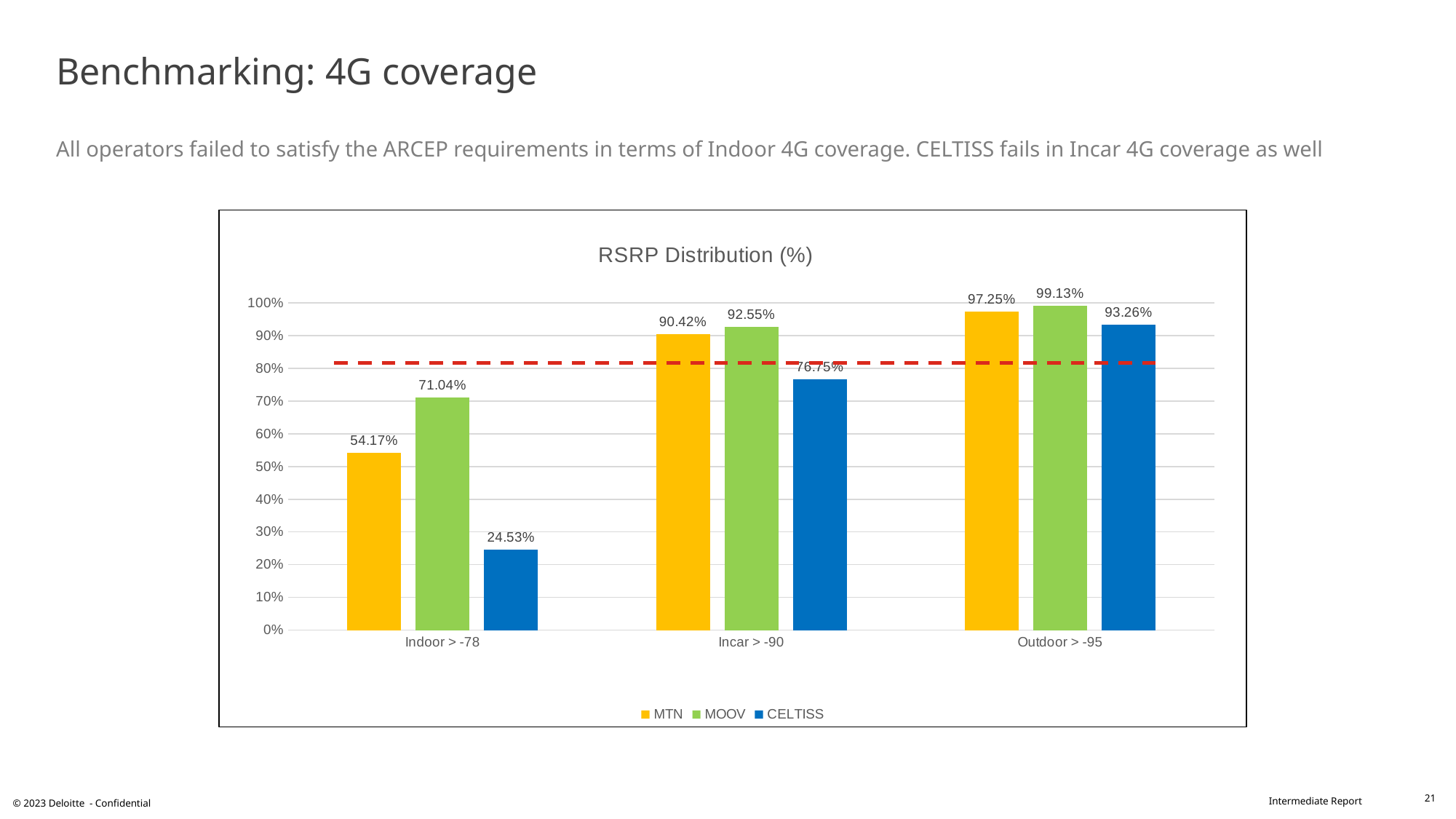
What is the title of the chart? RSRP Distribution (%) How many categories are shown on the x axis? 3 What is the value for CELTISS in the Incar > -90 category? 76.75% Which operator has the highest value in the Outdoor > -95 category? MOOV What kind of chart is shown on the slide? Bar chart What is the value for MTN in the Indoor > -78 category? 54.17% What is the difference between MOOV and MTN in the Indoor > -78 category? 16.87% What is the value for MOOV in the Outdoor > -95 category? 99.13% How many series does the legend list? 3 Do the values for CELTISS rise or fall from Indoor > -78 to Outdoor > -95? Rise Which operator has the lowest value in the Indoor > -78 category? CELTISS Which is larger in the Incar > -90 category: MTN or CELTISS? MTN